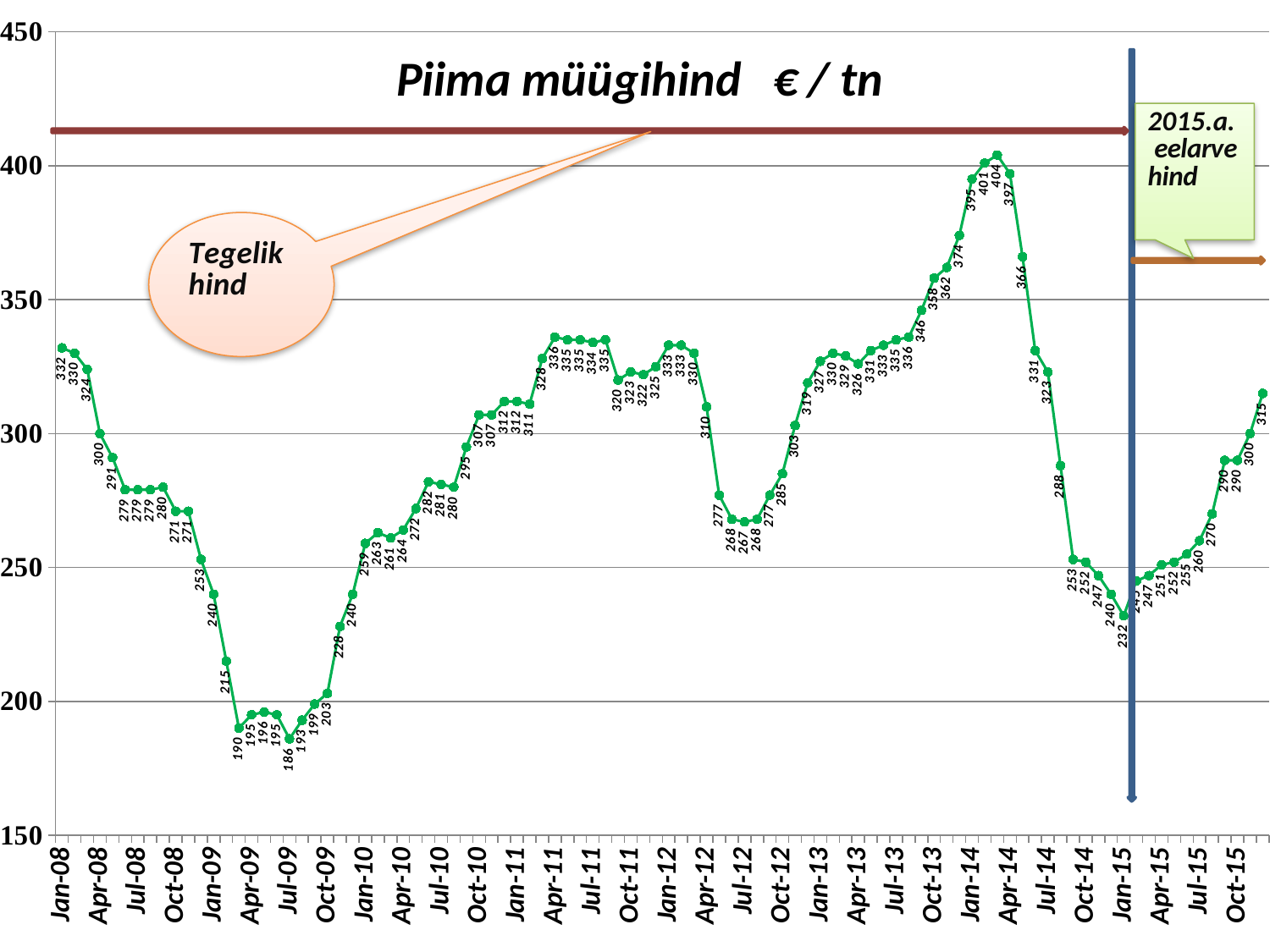
What is the value for Jan-08? 332 What is the title of the chart? Piima müügihind € / tn What is the value for Jan-14? 395 What is the lowest value plotted on the chart? 186 Do the values rise or fall from Jan-15 to the end of the series? rise What is the highest value plotted on the chart? 404 Is the value for Jul-09 greater or less than 200? less Which is larger, the value for Jan-14 or the value for Jan-10? Jan-14 What does the green callout on the right of the chart say? 2015.a. eelarve hind What type of chart is shown on the slide? line chart What is the difference between the value for Jan-08 and the value for Jan-15? 100 What is the value for Jan-15? 232